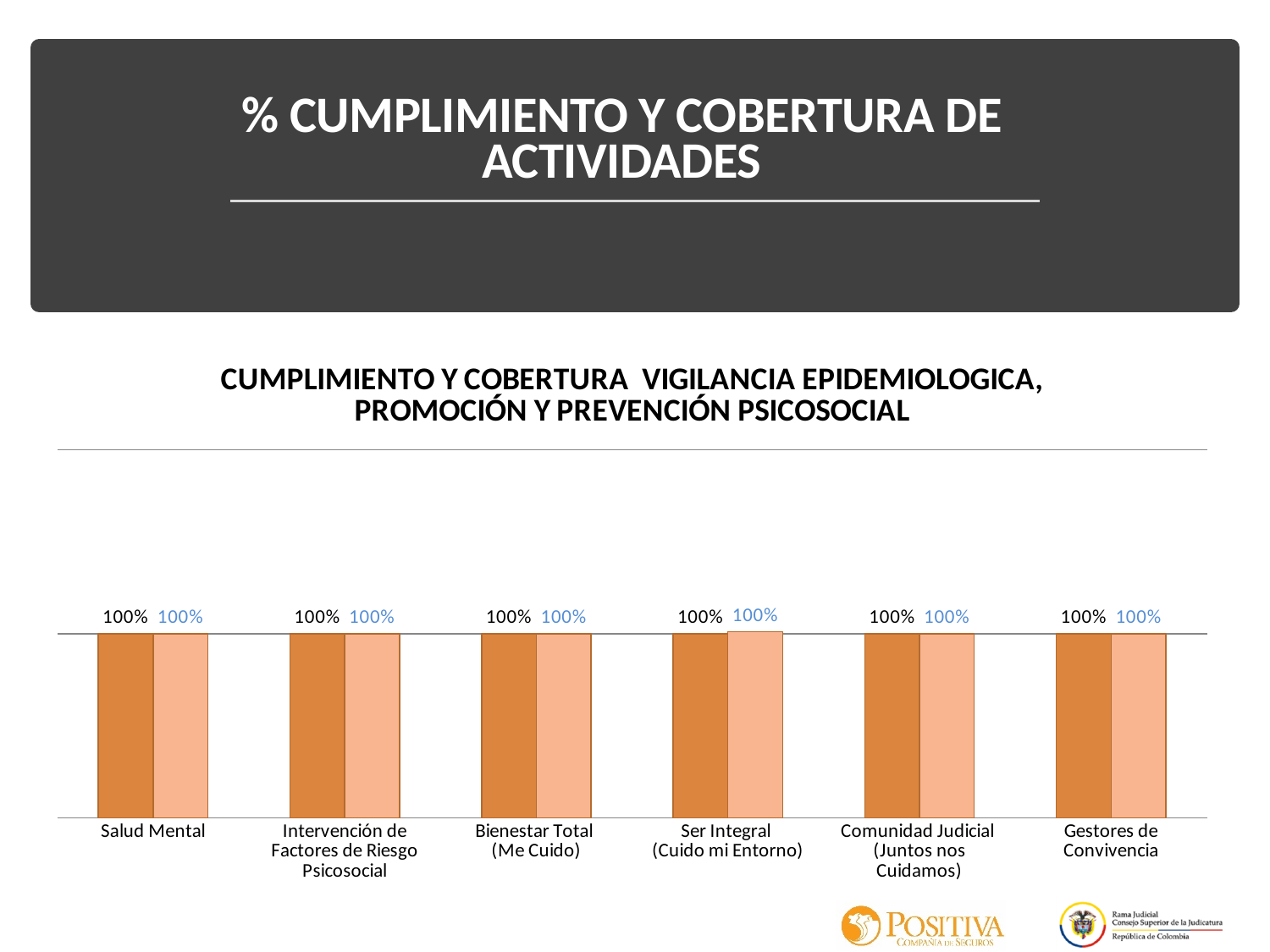
What is the label of the first category on the x axis? Salud Mental How many categories are shown along the x axis of the chart? 6 What value is labelled on the light orange bar for Ser Integral (Cuido mi Entorno)? 100% What is the value of the light orange bar for Gestores de Convivencia? 100% What is the value of the dark orange bar for Salud Mental? 100% Do the values rise, fall, or stay flat across the categories from left to right? stay flat What is the value of the dark orange bar for Comunidad Judicial (Juntos nos Cuidamos)? 100% What is the difference between the dark orange bar and the light orange bar for Intervención de Factores de Riesgo Psicosocial? 0% What value is labelled on the dark orange bar for Bienestar Total (Me Cuido)? 100% What is the title of the chart? CUMPLIMIENTO Y COBERTURA VIGILANCIA EPIDEMIOLOGICA, PROMOCIÓN Y PREVENCIÓN PSICOSOCIAL What kind of chart is shown on the slide? bar chart How many bars are shown for each category in the chart? 2